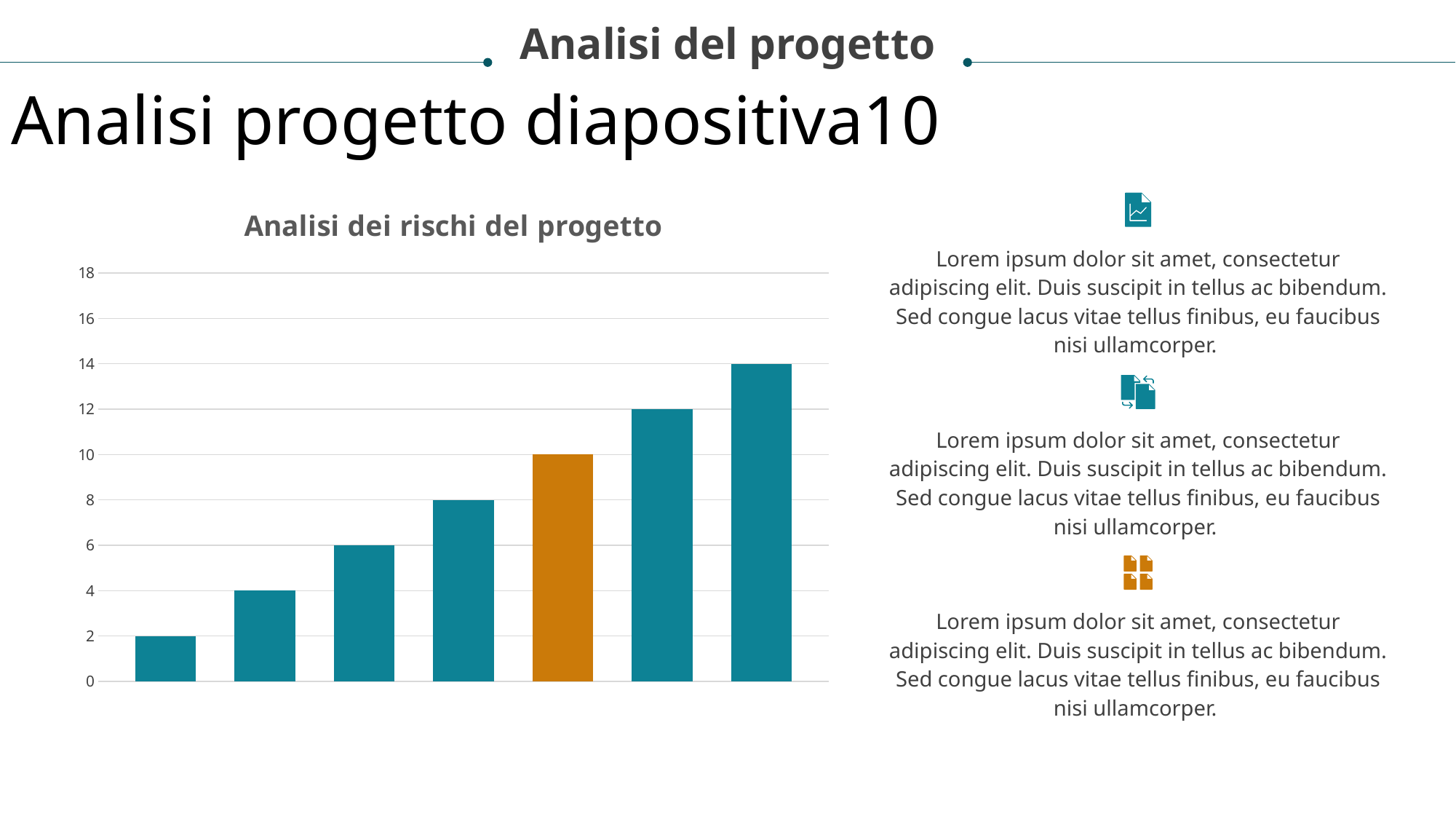
What is the title of the chart? Analisi dei rischi del progetto Which bar is the tallest? the rightmost (seventh) bar Is the value of the sixth bar greater or less than 10? greater How many bars does the chart contain? 7 What kind of chart is shown on the slide? bar chart Which bar is the shortest? the leftmost (first) bar What is the difference between the tallest bar and the shortest bar? 12 Do the bar values rise or fall from left to right? rise What is the value of the orange bar? 10 What is the value of the last (rightmost) bar? 14 Which bar is coloured differently from the others? the fifth bar (orange) What is the value of the first (leftmost) bar? 2